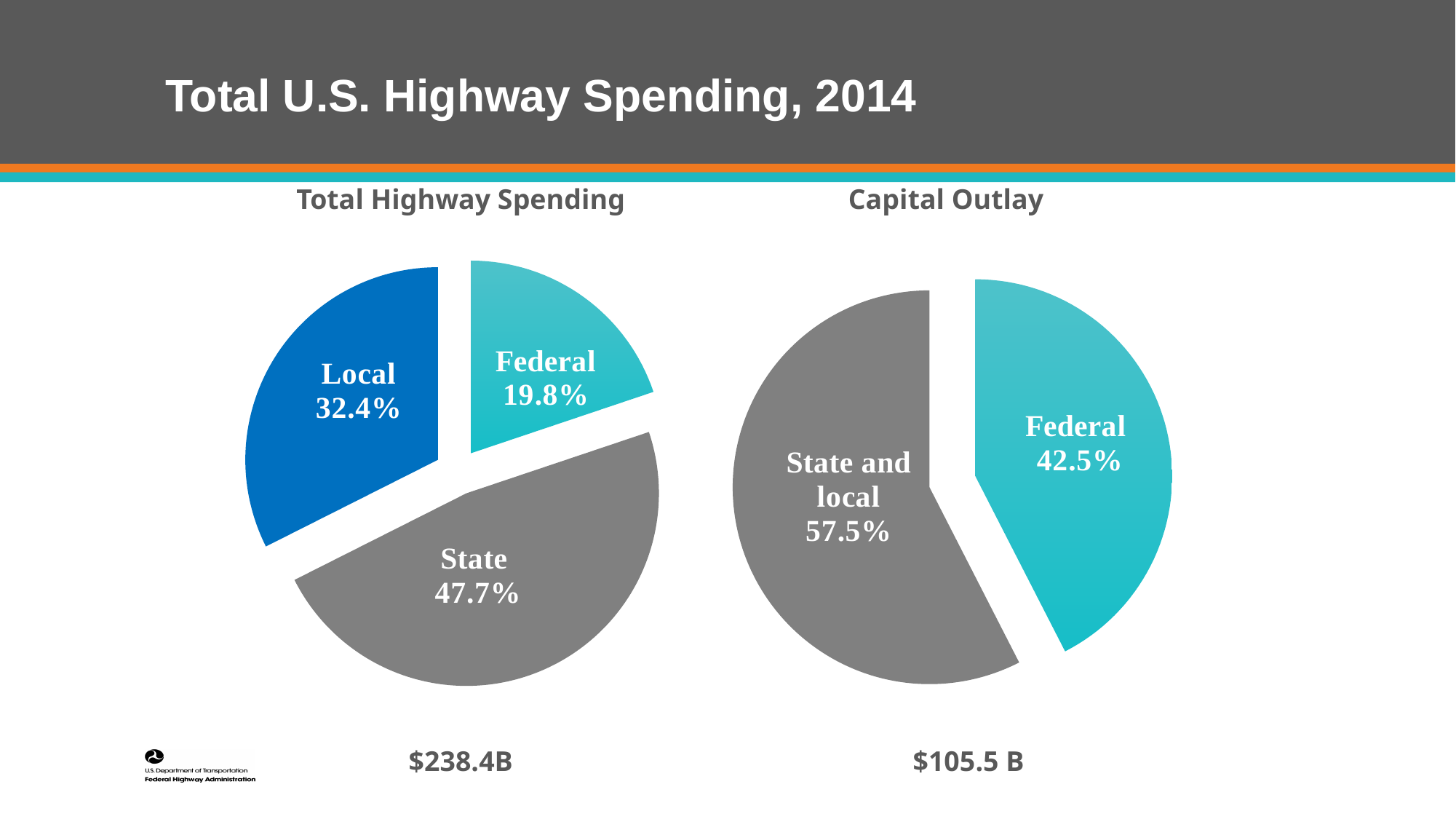
In the Total Highway Spending chart, what is the difference in percentage points between the State and Local shares? 15.3 In the Total Highway Spending chart, which category has the smallest share? Federal In the Capital Outlay chart, what is the difference in percentage points between the State and local and Federal shares? 15 In the Total Highway Spending chart, what share does State account for? 47.7% In the Total Highway Spending chart, what share does Local account for? 32.4% What type of chart is the Capital Outlay chart? Pie chart In the Capital Outlay chart, which category has the larger share? State and local In the Capital Outlay chart, what share does Federal account for? 42.5% In the Total Highway Spending chart, which category has the largest share? State In the Total Highway Spending chart, what share does Federal account for? 19.8% In the Capital Outlay chart, what share does State and local account for? 57.5% How many slices does the Total Highway Spending chart have? 3